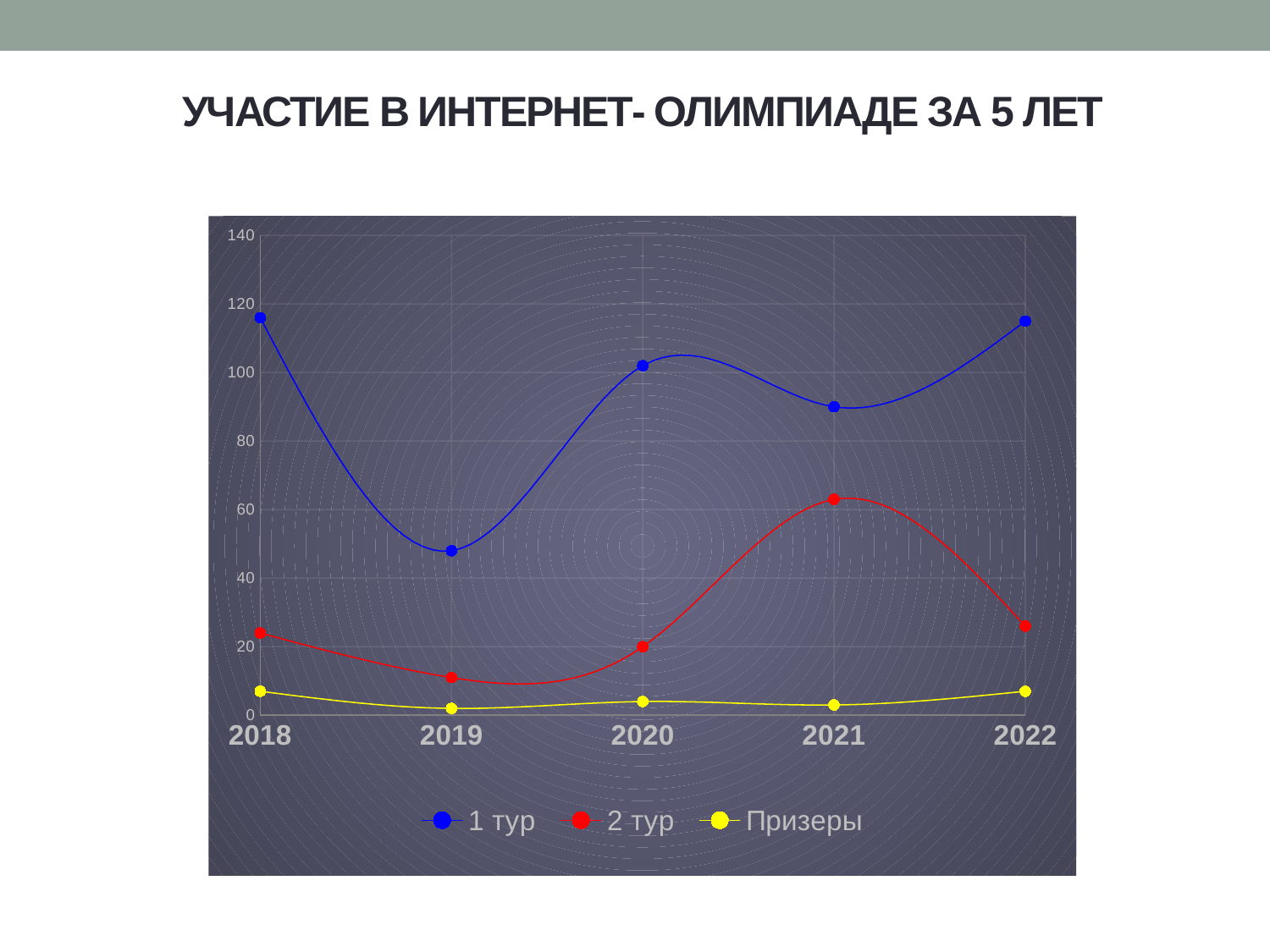
Is the value for 1 тур in 2019 greater or less than 60? less In which year is the value for 2 тур highest? 2021 Which colour is used for the Призеры series? yellow How many series does the legend list? 3 Is the value for 2 тур in 2021 greater or less than 40? greater What kind of chart is shown on the slide? line chart In which year is the value for 1 тур lowest? 2019 Is the value for 1 тур in 2018 greater or less than 100? greater In which year is the value for 2 тур lowest? 2019 How many years are shown on the x axis? 5 Does the value for 2 тур rise or fall from 2020 to 2021? rise Which is larger for 1 тур: the value in 2020 or the value in 2021? 2020